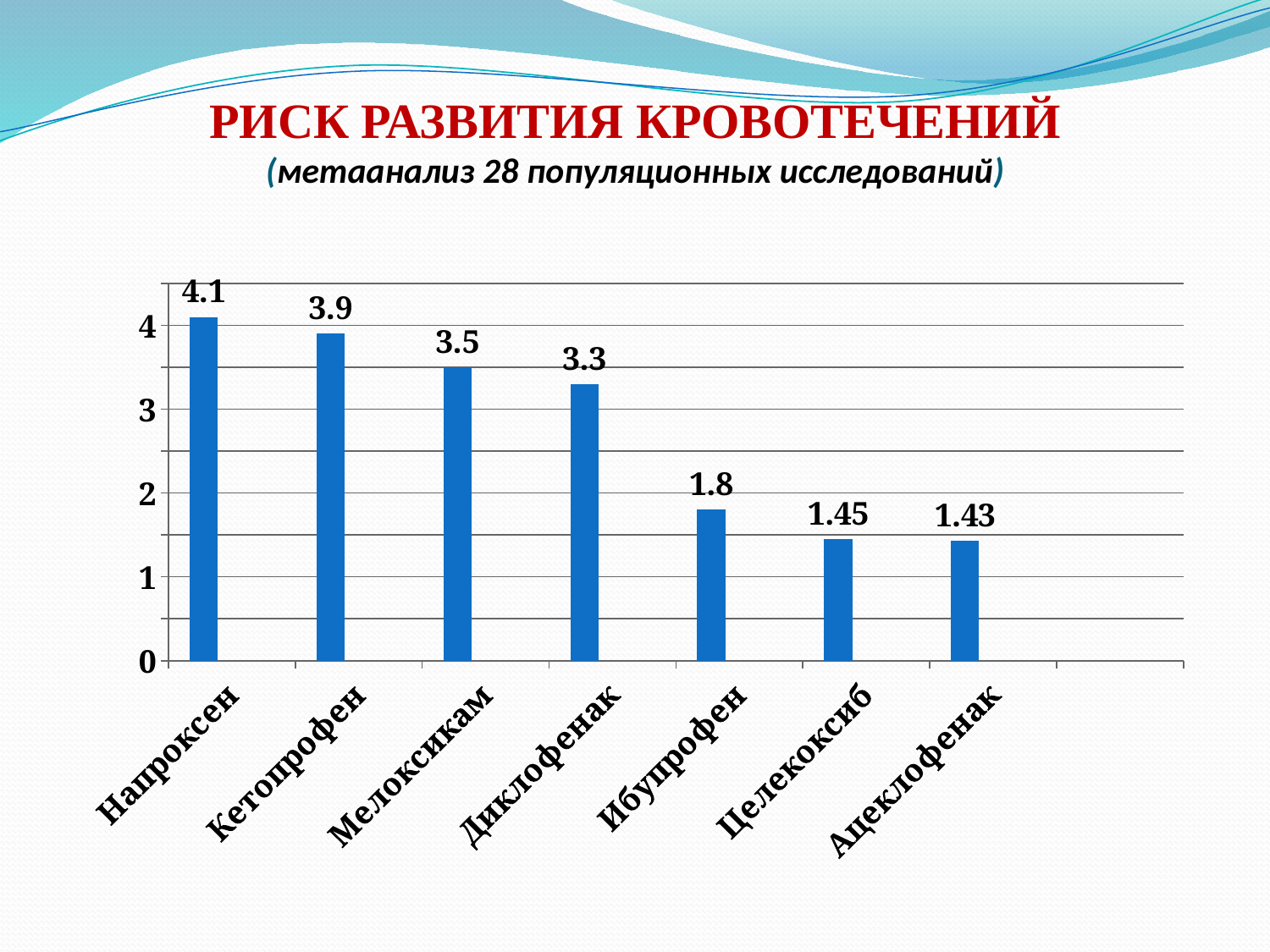
What is the value for Целекоксиб? 1.45 What kind of chart is shown on the slide? bar chart How many categories are shown on the x axis? 7 What is the value for Напроксен? 4.1 Do the values rise or fall from left to right along the x axis? fall Which category has the highest value? Напроксен Which is larger, the value for Кетопрофен or the value for Мелоксикам? Кетопрофен What is the difference between the values for Напроксен and Диклофенак? 0.8 What is the difference between the values for Мелоксикам and Ибупрофен? 1.7 Which category has the lowest value? Ацеклофенак Is the value for Диклофенак greater or less than 3? greater What is the value for Ибупрофен? 1.8